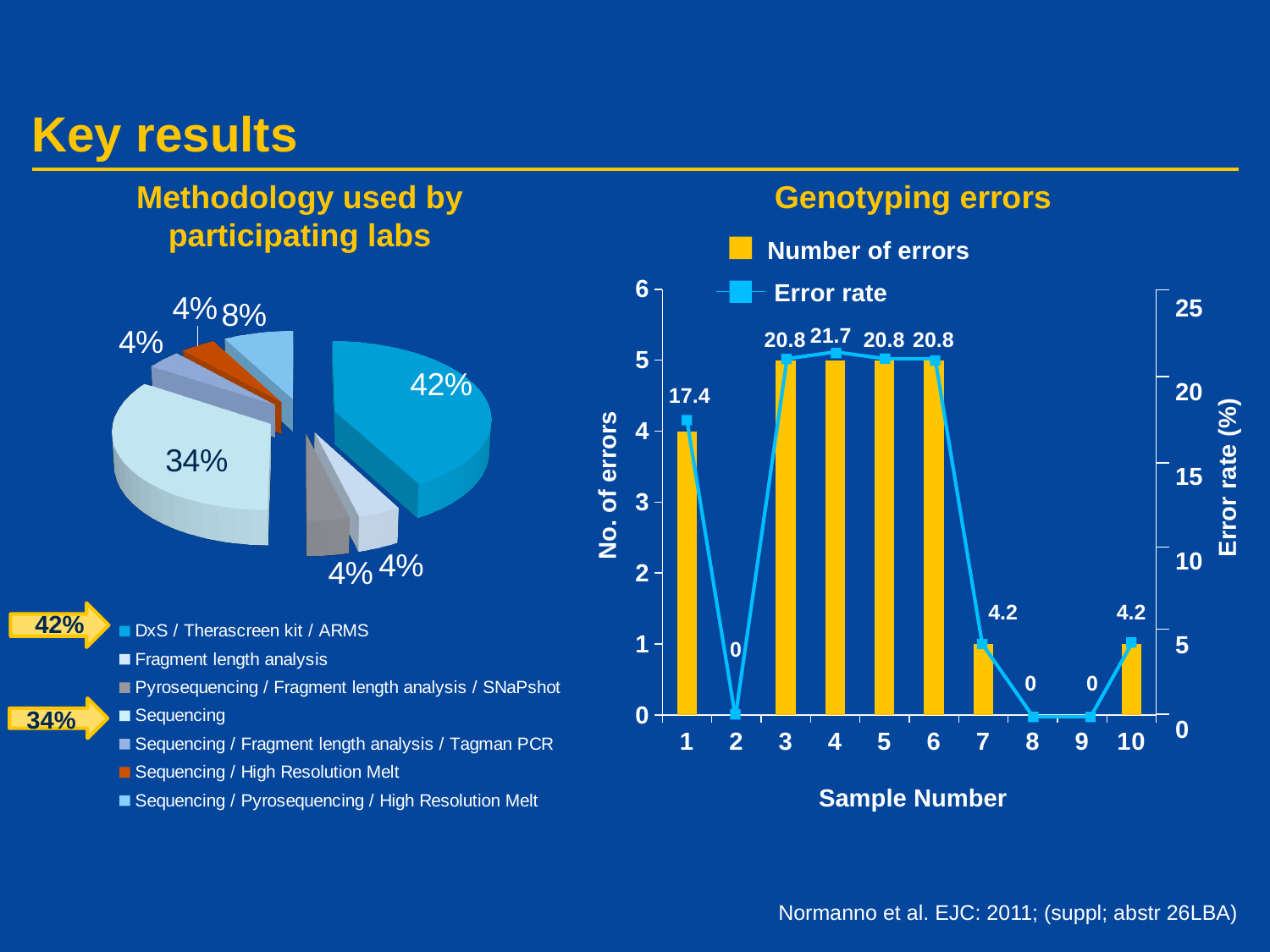
In the 'Genotyping errors' chart, what is the difference between the error rate for sample 4 and the error rate for sample 3? 0.9 In the 'Methodology used by participating labs' pie chart, what share of labs used DxS / Therascreen kit / ARMS? 42% How many methodologies are listed in the legend of the 'Methodology used by participating labs' pie chart? 7 In the 'Genotyping errors' chart, which sample number has the highest error rate? 4 How many series does the legend of the 'Genotyping errors' chart list? 2 In the 'Methodology used by participating labs' pie chart, what share of labs used Sequencing? 34% In the 'Genotyping errors' chart, what is the error rate for sample number 1? 17.4 What kind of chart is the 'Methodology used by participating labs' chart? Pie chart In the 'Methodology used by participating labs' pie chart, which methodology has the largest slice? DxS / Therascreen kit / ARMS How many sample numbers are shown on the x axis of the 'Genotyping errors' chart? 10 In the 'Genotyping errors' chart, how many errors were recorded for sample number 3? 5 In the 'Genotyping errors' chart, what is the error rate for sample number 4? 21.7